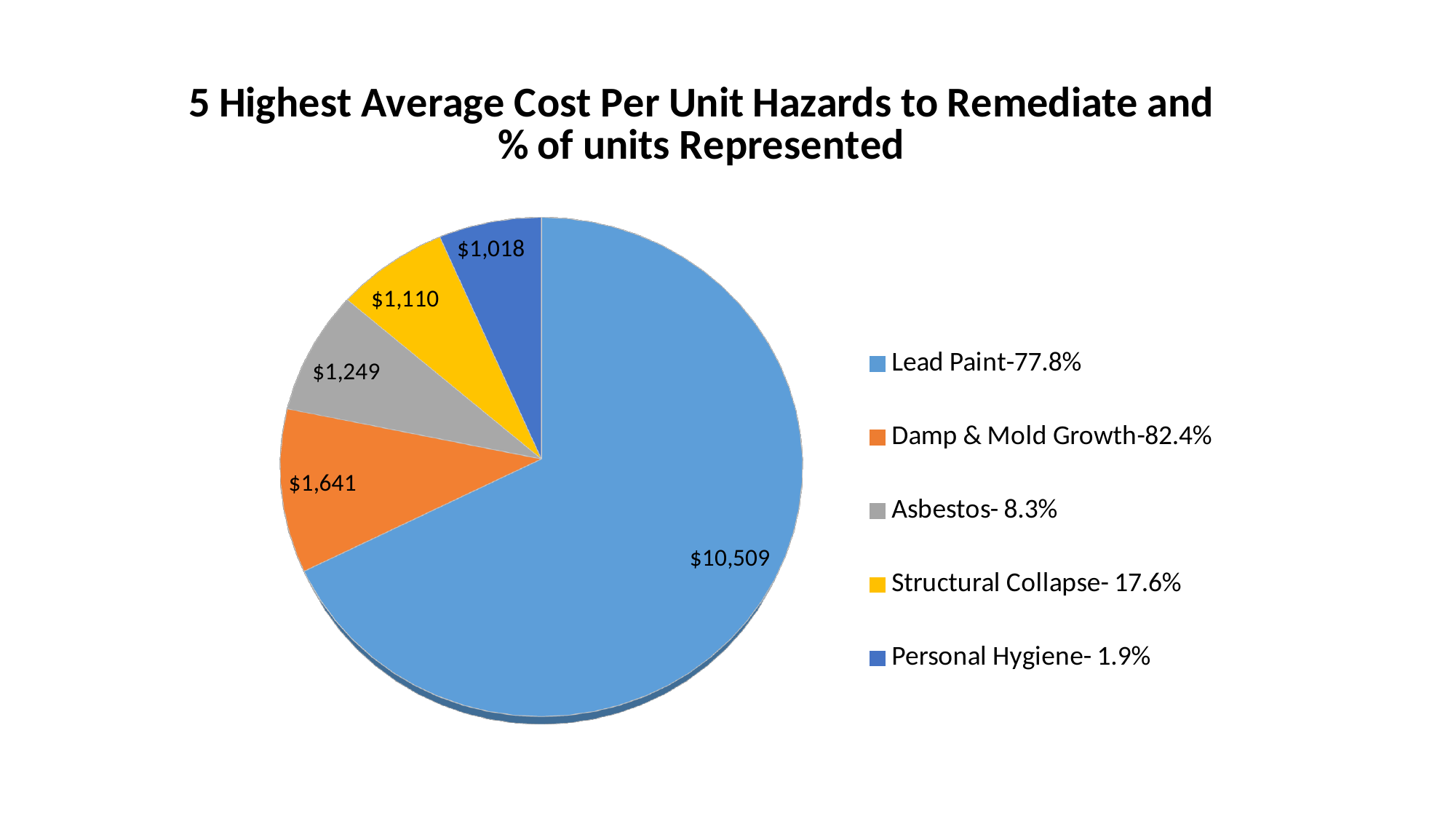
What percentage of units is listed in the legend for Damp & Mold Growth? 82.4% What is the value shown for the Personal Hygiene slice? $1,018 How many slices does the pie chart have? 5 What is the value shown for the Structural Collapse slice? $1,110 What is the average cost per unit shown for the Lead Paint slice? $10,509 Which hazard has the lowest average cost per unit in the pie chart? Personal Hygiene What is the difference between the Lead Paint value and the Damp & Mold Growth value? $8,868 What kind of chart is shown on the slide? pie chart Which is larger, the value for Asbestos or the value for Structural Collapse? Asbestos What is the value shown for the Asbestos slice? $1,249 Which hazard has the highest average cost per unit in the pie chart? Lead Paint What is the value shown for the Damp & Mold Growth slice? $1,641